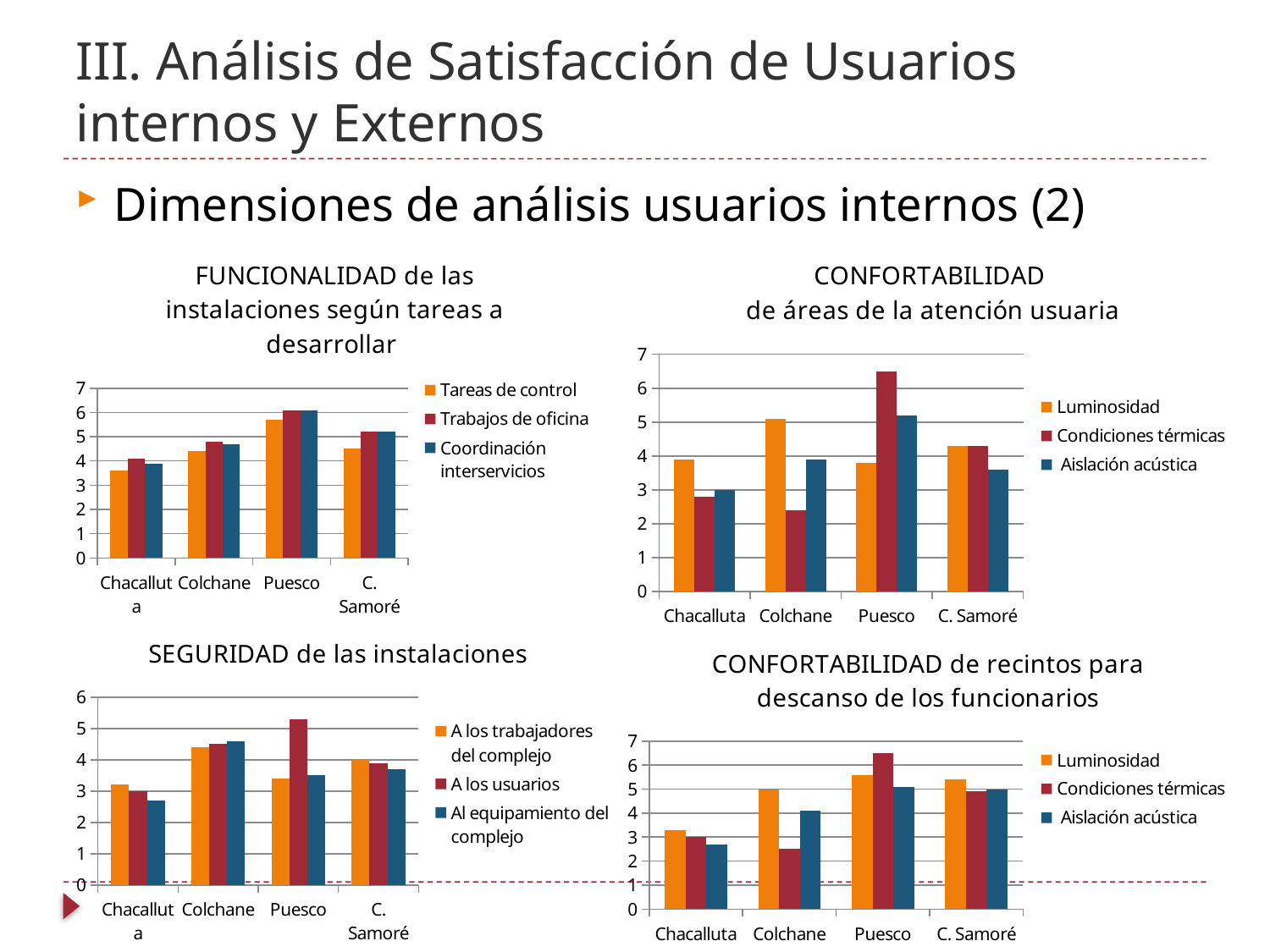
In the 'CONFORTABILIDAD de áreas de la atención usuaria' chart, is the Luminosidad value for Colchane greater or less than 4? greater In the 'FUNCIONALIDAD de las instalaciones según tareas a desarrollar' chart, is the 'Tareas de control' value for Chacalluta greater or less than 4? less How many categories are shown on the x axis of the 'SEGURIDAD de las instalaciones' chart? 4 In the 'SEGURIDAD de las instalaciones' chart, which category has the highest value for 'A los usuarios'? Puesco In the 'CONFORTABILIDAD de recintos para descanso de los funcionarios' chart, which category has the lowest value for Condiciones térmicas? Colchane In the 'SEGURIDAD de las instalaciones' chart, is the value for 'A los trabajadores del complejo' at Colchane greater or less than 4? greater What are the three legend entries of the 'SEGURIDAD de las instalaciones' chart? A los trabajadores del complejo, A los usuarios, Al equipamiento del complejo In the 'CONFORTABILIDAD de áreas de la atención usuaria' chart, which category has the lowest value for Condiciones térmicas? Colchane What kind of chart is the 'FUNCIONALIDAD de las instalaciones según tareas a desarrollar' chart? Bar chart How many series does the legend of the 'CONFORTABILIDAD de áreas de la atención usuaria' chart list? 3 In the 'FUNCIONALIDAD de las instalaciones según tareas a desarrollar' chart, which is larger for 'Tareas de control': Puesco or Colchane? Puesco In the 'CONFORTABILIDAD de áreas de la atención usuaria' chart, which category has the highest value for Condiciones térmicas? Puesco